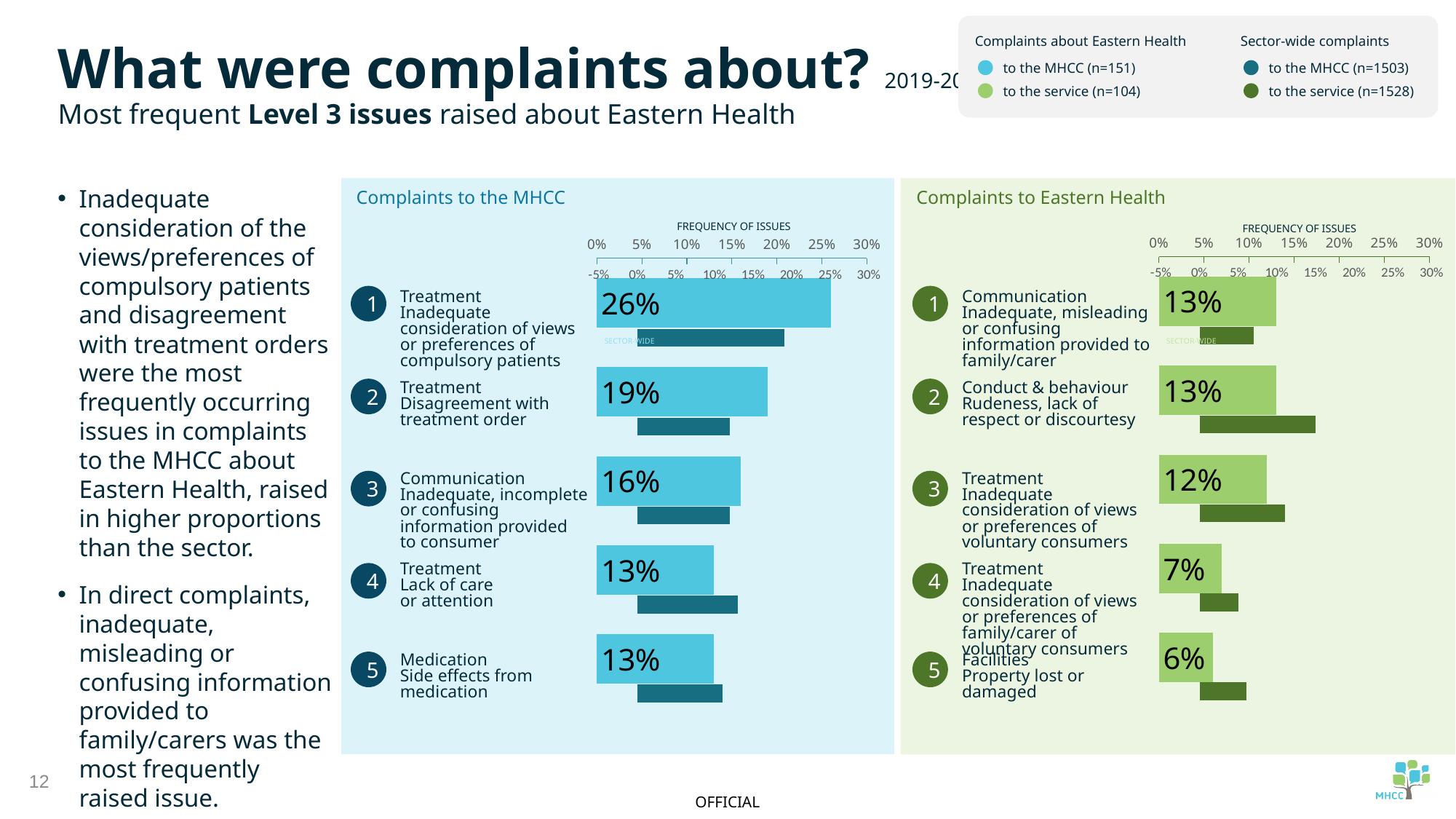
In the 'Complaints to the MHCC' chart, which issue has the highest frequency? Treatment – Inadequate consideration of views or preferences of compulsory patients In the 'Complaints to the MHCC' chart, which has a higher frequency: 'Communication – Inadequate, incomplete or confusing information provided to consumer' or 'Treatment – Lack of care or attention'? Communication – Inadequate, incomplete or confusing information provided to consumer In the 'Complaints to the MHCC' chart, what is the difference between the frequency for issue 1 (26%) and issue 2 (19%)? 7 percentage points How many issues are listed in the 'Complaints to Eastern Health' chart? 5 In the 'Complaints to the MHCC' chart, what is the frequency of issues for 'Treatment – Disagreement with treatment order'? 19% How many series does the legend at the top right of the slide list? 4 In the 'Complaints to the MHCC' chart, is the sector-wide value for issue 1 (Treatment – Inadequate consideration of views or preferences of compulsory patients) greater or less than 15%? greater In the 'Complaints to Eastern Health' chart, what is the difference between the frequency for 'Conduct & behaviour' and 'Treatment – Inadequate consideration of views or preferences of family/carer of voluntary consumers'? 6 percentage points In the 'Complaints to Eastern Health' chart, what is the frequency of issues for 'Facilities – Property lost or damaged'? 6% In the 'Complaints to Eastern Health' chart, what is the frequency of issues for 'Treatment – Inadequate consideration of views or preferences of voluntary consumers'? 12% What type of chart is used in the 'Complaints to the MHCC' panel? Bar chart In the 'Complaints to Eastern Health' chart, which issue has the lowest frequency? Facilities – Property lost or damaged